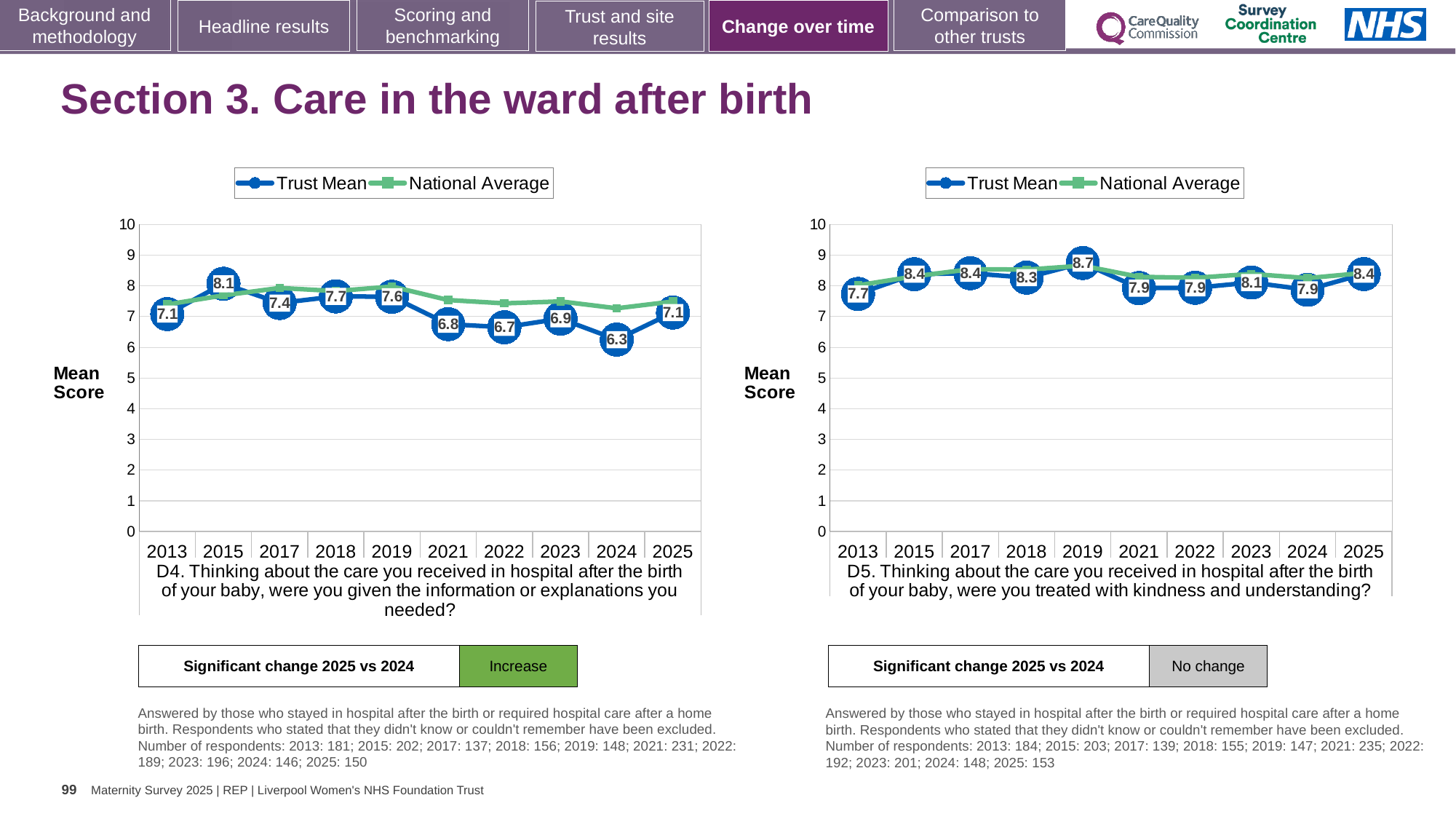
In the D4 chart on the left, which year has the lowest Trust Mean score? 2024 In the D4 chart on the left, which year has the highest Trust Mean score? 2015 In the D5 chart on the right, what is the Trust Mean score for 2019? 8.7 In the D4 chart on the left, what is the Trust Mean score for 2015? 8.1 In the D5 chart on the right, which year has the lowest Trust Mean score? 2013 In the D5 chart on the right, is the Trust Mean score for 2013 larger or smaller than the score for 2025? smaller In the D5 chart on the right, how many series does the legend list? 2 In the D4 chart on the left, what is the Trust Mean score for 2024? 6.3 In the D5 chart on the right, which year has the highest Trust Mean score? 2019 What type of chart is the D4 chart on the left? line chart In the D4 chart on the left, what is the difference between the Trust Mean scores for 2025 and 2024? 0.8 In the D4 chart on the left, how many years are shown on the x axis? 10